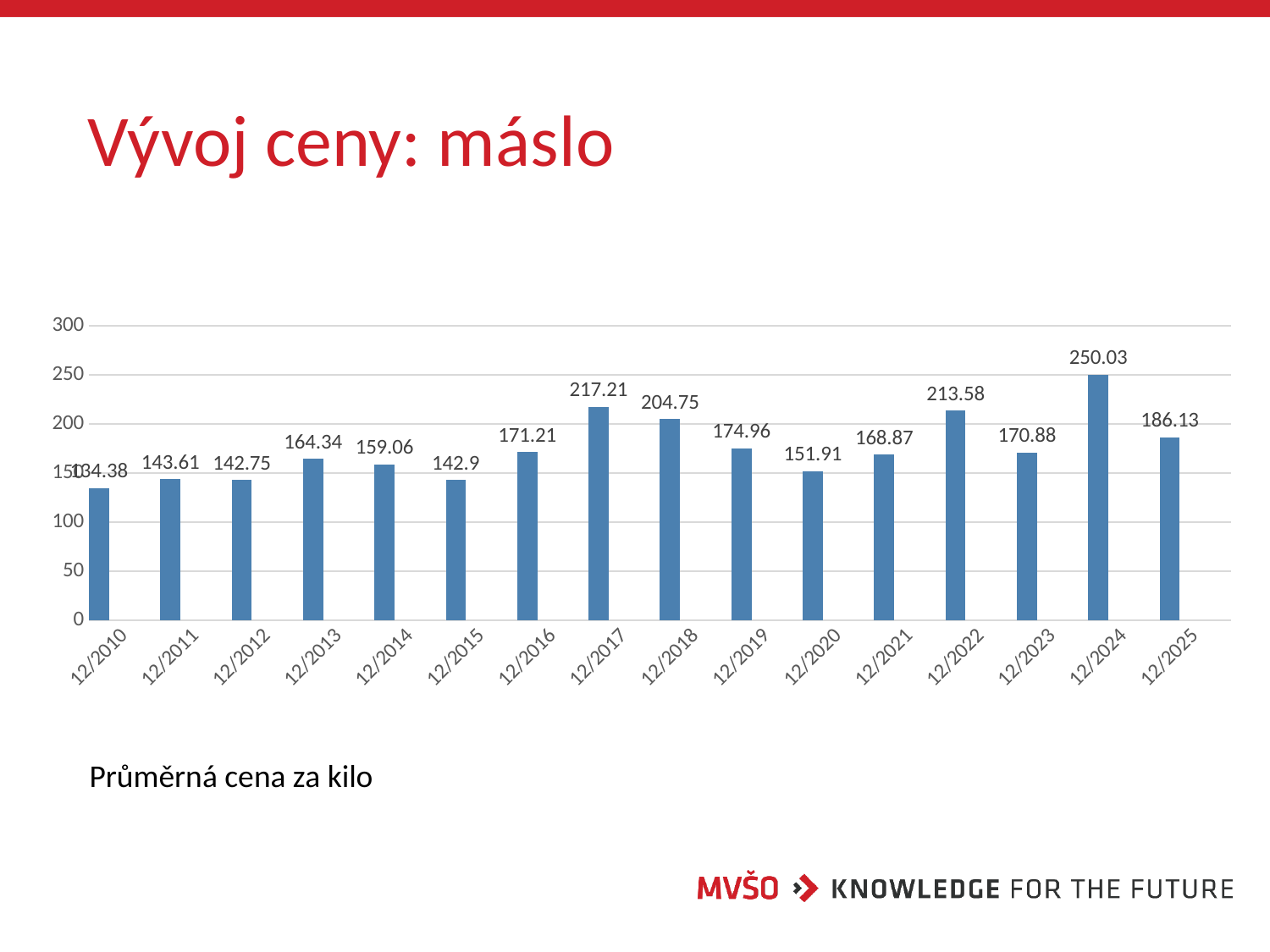
Is the value for 12/2020 greater or less than 200? less What kind of chart is shown on the slide? bar chart What is the difference between the values for 12/2017 and 12/2018? 12.46 What is the value for 12/2020? 151.91 Which period has the lowest value? 12/2010 What is the value for 12/2017? 217.21 What is the difference between the values for 12/2024 and 12/2025? 63.9 Which is larger, the value for 12/2017 or the value for 12/2022? 12/2017 What is the value for 12/2025? 186.13 How many bars are shown in the chart? 16 What is the value for 12/2024? 250.03 Which period has the highest value? 12/2024